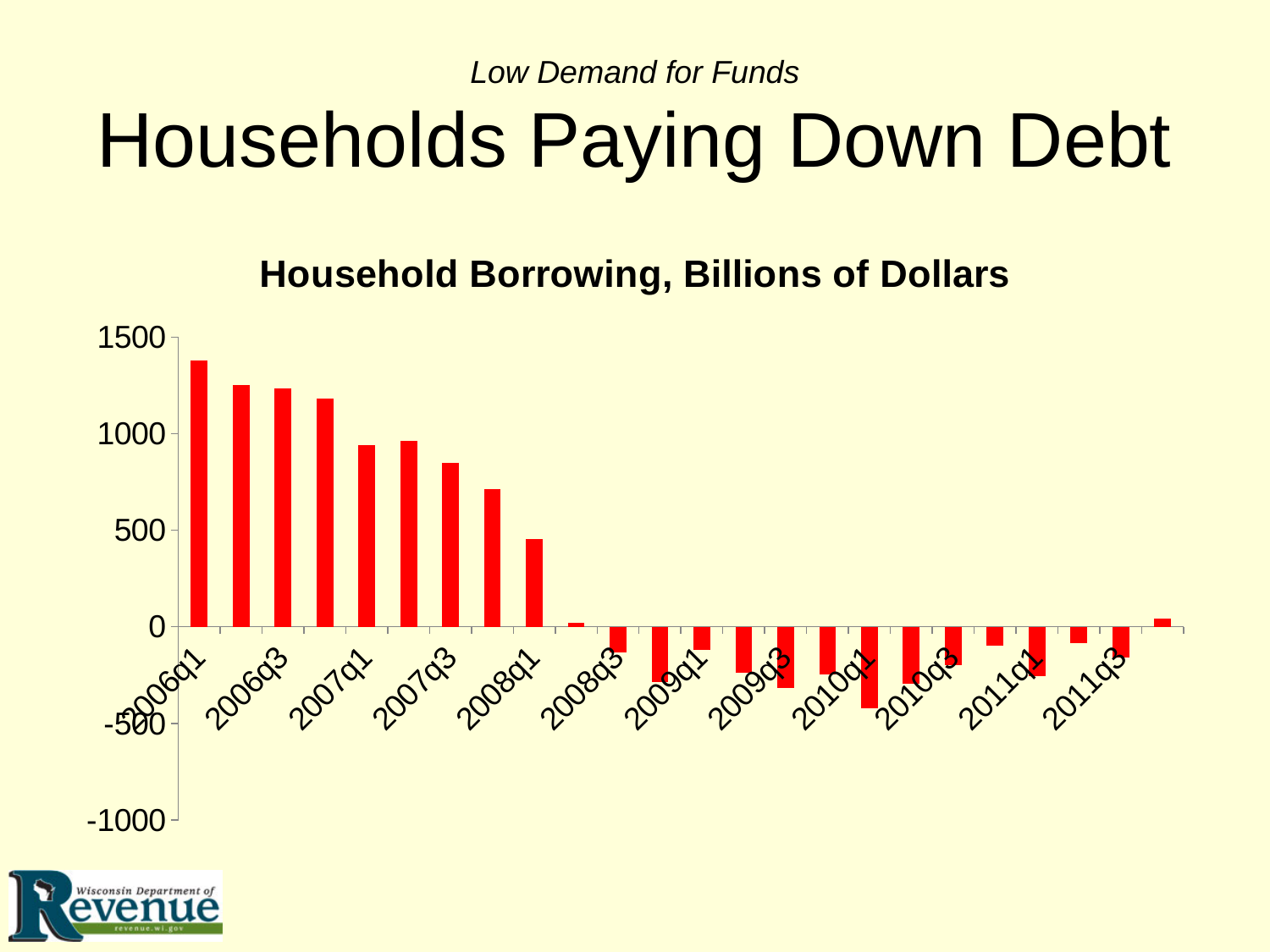
Is the value for 2010q1 greater or less than 0? less Which labeled quarter has the lowest (most negative) household borrowing value? 2010q1 Do the values rise or fall from 2006q1 to 2008q1? fall What is the title of the chart? Household Borrowing, Billions of Dollars Is the value for 2007q3 greater or less than 500? greater Is the value for 2006q1 greater or less than 1000? greater How many quarter labels are shown on the x axis? 12 Which is larger, the value for 2006q1 or the value for 2007q1? 2006q1 Which quarter has the highest household borrowing value? 2006q1 What kind of chart is shown on the slide? bar chart